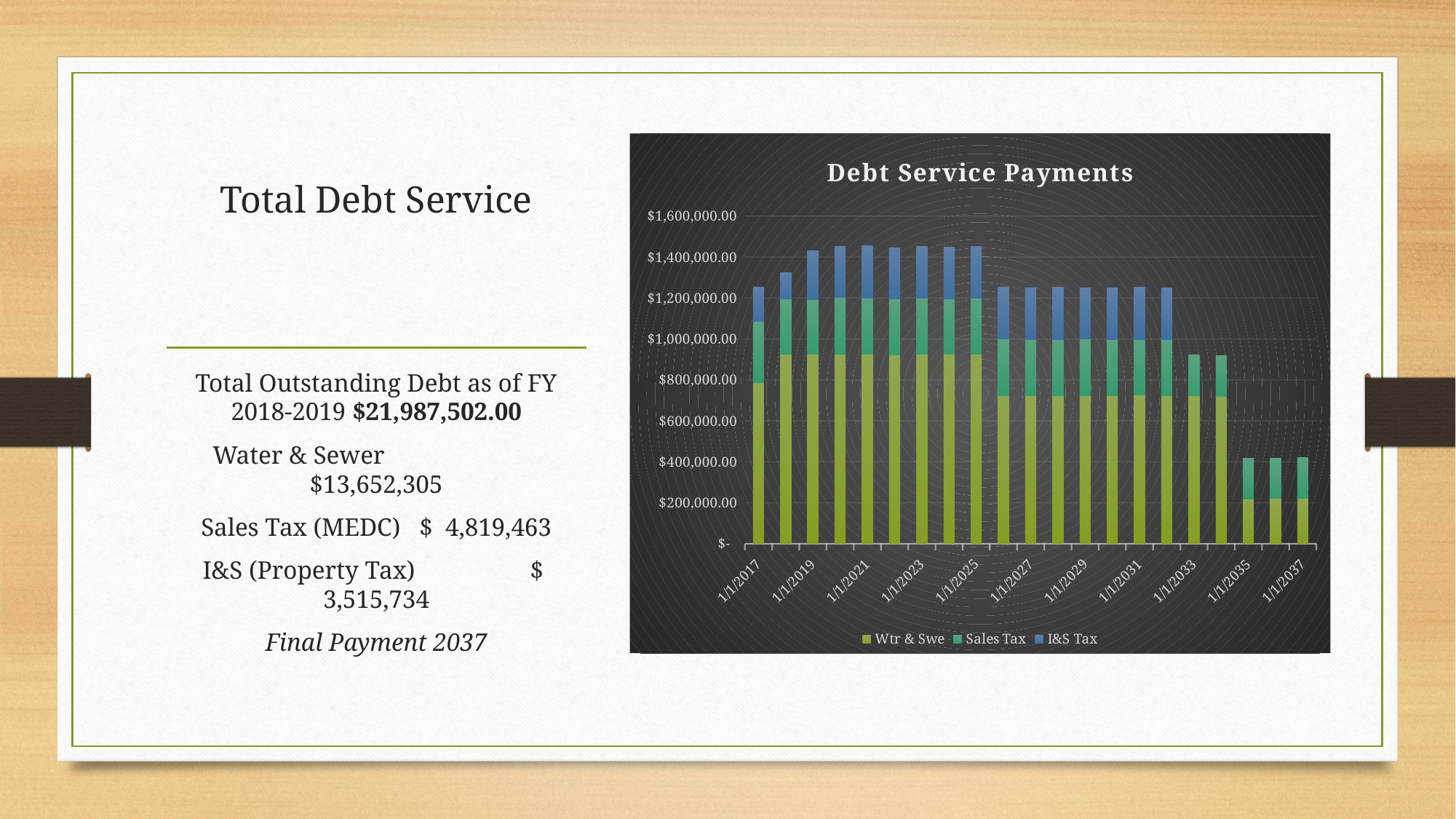
What is the title of the chart on the slide? Debt Service Payments Is the total debt service payment for 1/1/2021 greater or less than $1,400,000.00? greater Is the total debt service payment for 1/1/2035 greater or less than $600,000.00? less Is the total debt service payment for 1/1/2027 greater or less than $1,000,000.00? greater What type of chart is the Debt Service Payments chart? Stacked bar chart How many series does the legend of the Debt Service Payments chart list? 3 Which series is missing from the bars for 1/1/2035 through 1/1/2037? I&S Tax How many bars are plotted in the Debt Service Payments chart? 21 Do the total debt service payments rise or fall from 1/1/2025 to 1/1/2037? fall What are the three series listed in the legend of the Debt Service Payments chart? Wtr & Swe, Sales Tax, I&S Tax Which has a larger total debt service payment, 1/1/2017 or 1/1/2021? 1/1/2021